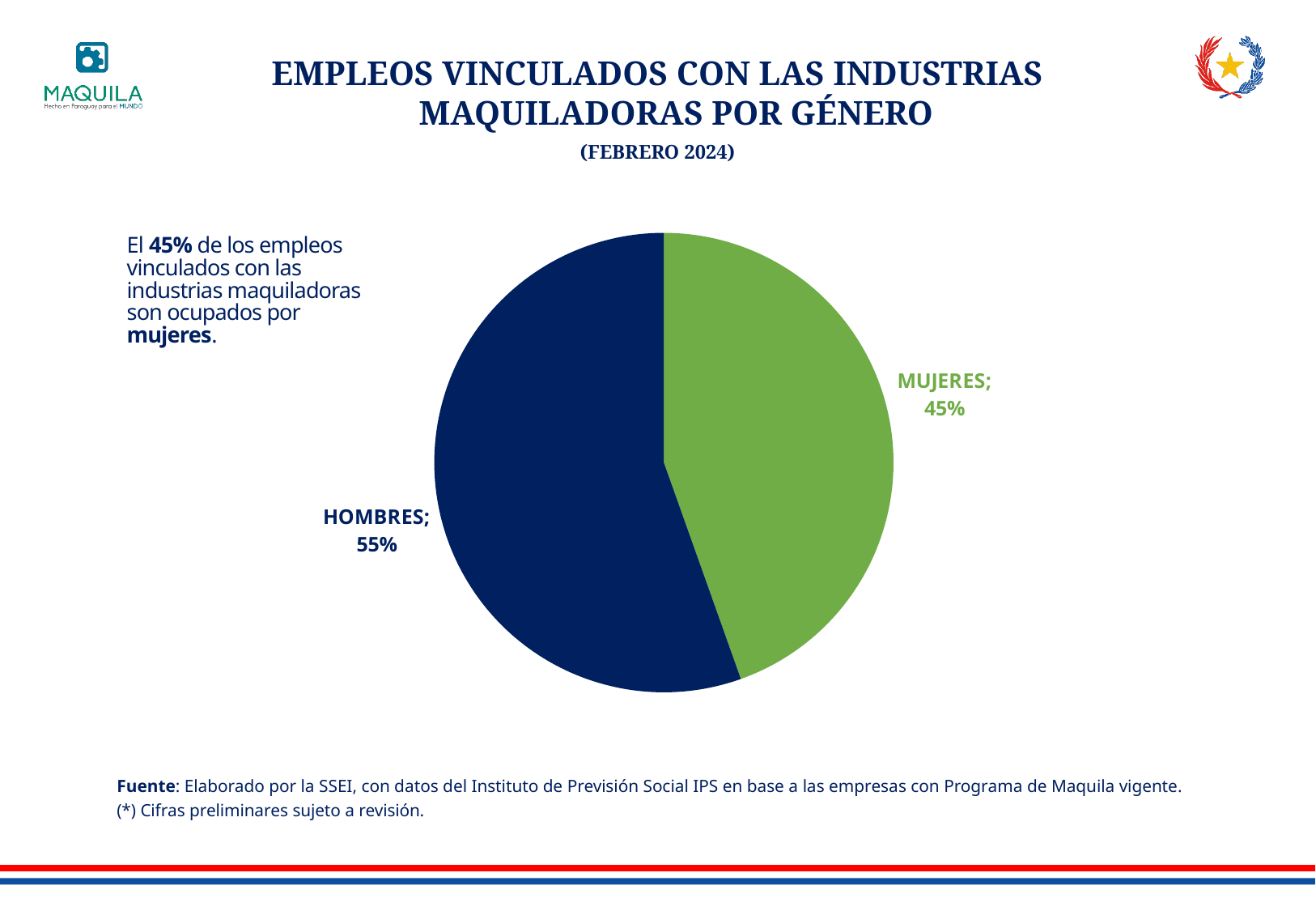
What type of chart is shown on the slide? Pie chart What colour is the HOMBRES slice of the pie chart? Dark blue What is the total of the two slices shown in the pie chart? 100% Which category has the smallest share of the pie? MUJERES How many slices does the pie chart have? 2 Which is larger, the share for HOMBRES or the share for MUJERES? HOMBRES Which category has the largest share of the pie? HOMBRES What percentage of the pie is labelled HOMBRES? 55% What month and year does the chart title refer to? FEBRERO 2024 What is the difference in percentage points between HOMBRES and MUJERES? 10 What share of the pie does the MUJERES slice represent? 45% What percentage of the pie is labelled MUJERES? 45%